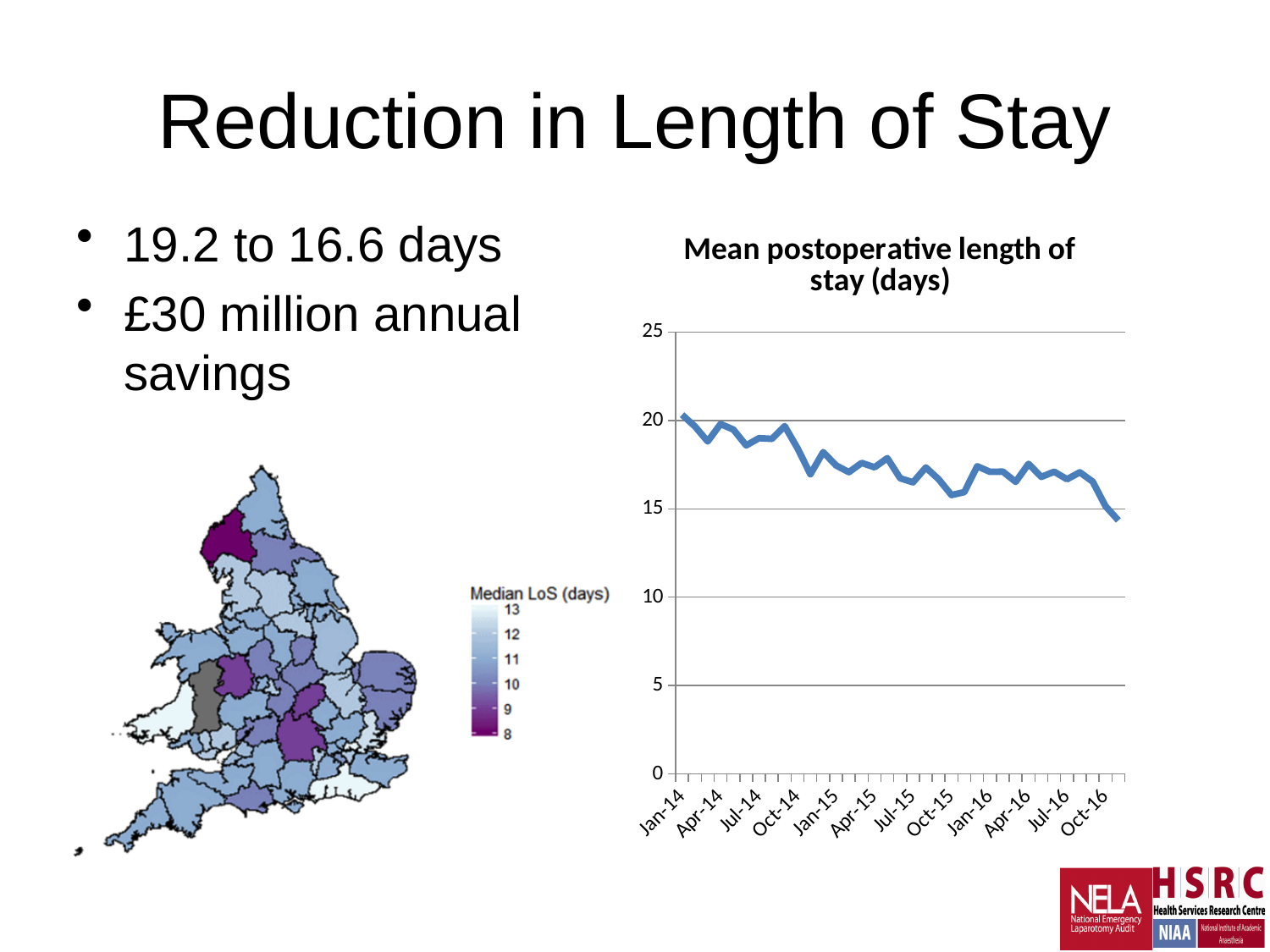
In the 'Mean postoperative length of stay (days)' chart, is the value for Apr-14 greater or less than 15? greater In the 'Mean postoperative length of stay (days)' chart, do the values generally rise or fall from Jan-14 to Oct-16? fall How many month labels are shown on the x axis of the 'Mean postoperative length of stay (days)' chart? 12 In the 'Mean postoperative length of stay (days)' chart, which is larger, the value for Apr-14 or the value for Apr-16? Apr-14 What is the highest value shown on the y axis of the 'Mean postoperative length of stay (days)' chart? 25 In the 'Mean postoperative length of stay (days)' chart, is the value for Jul-15 greater or less than 20? less What kind of chart is shown on the right of the slide? line chart What is the title of the chart on the right of the slide? Mean postoperative length of stay (days) In the 'Mean postoperative length of stay (days)' chart, is the value for Jan-14 greater or less than 15? greater In the 'Mean postoperative length of stay (days)' chart, which labelled month has the lowest value? Oct-16 In the 'Mean postoperative length of stay (days)' chart, which is larger, the value for Jan-14 or the value for Oct-16? Jan-14